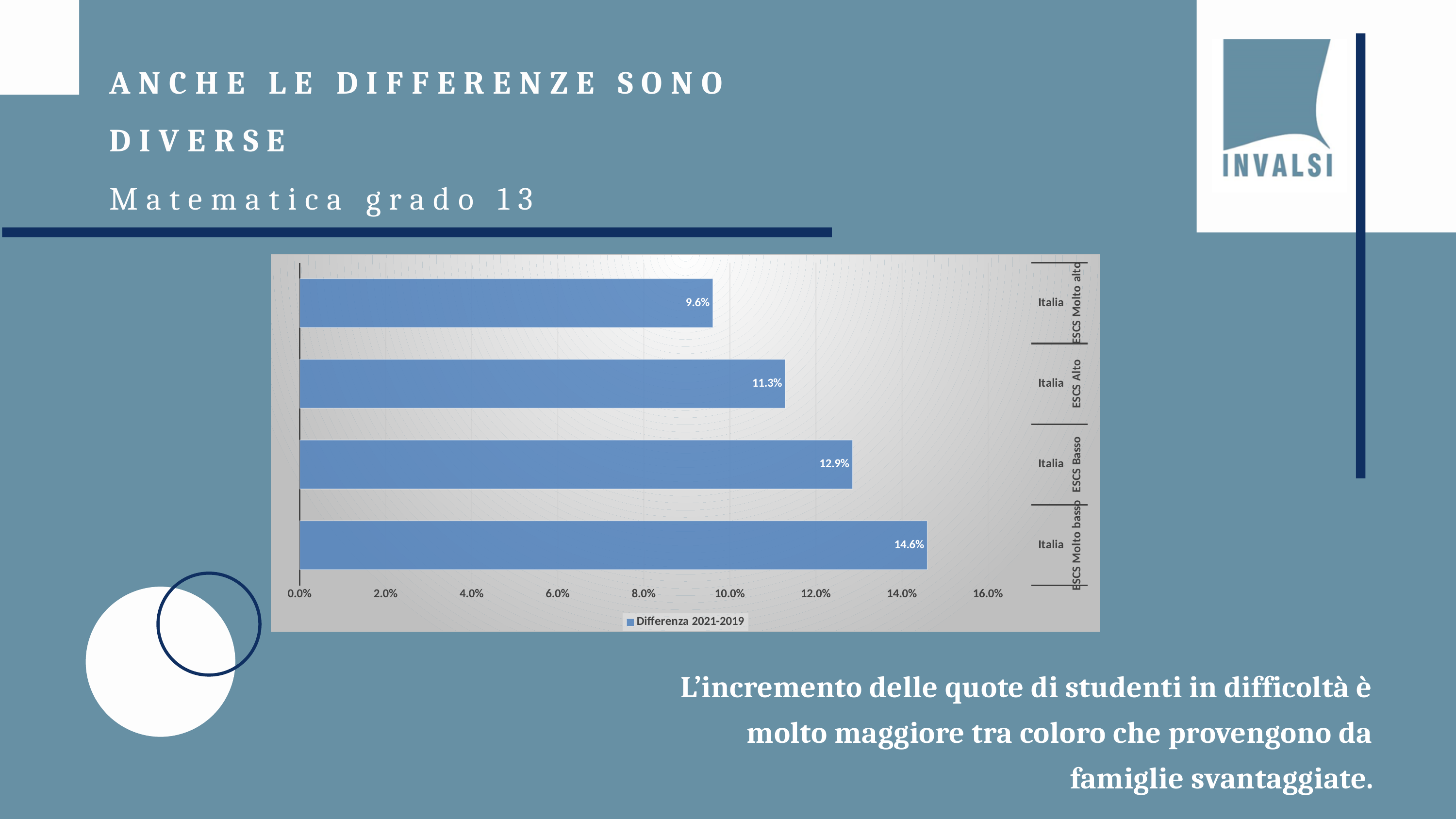
Which category has the lowest value? ESCS Molto alto What is the value for ESCS Molto alto? 9.6% What kind of chart is shown on the slide? bar chart What is the value for ESCS Basso? 12.9% What is the difference between the values for ESCS Molto basso and ESCS Molto alto? 5.0% Which category has the highest value? ESCS Molto basso Which is larger, the value for ESCS Alto or the value for ESCS Basso? ESCS Basso How many categories are shown in the chart? 4 What is the value for ESCS Molto basso? 14.6% What is the value for ESCS Alto? 11.3% What series name does the legend show? Differenza 2021-2019 Is the value for ESCS Alto greater or less than 12.0%? less